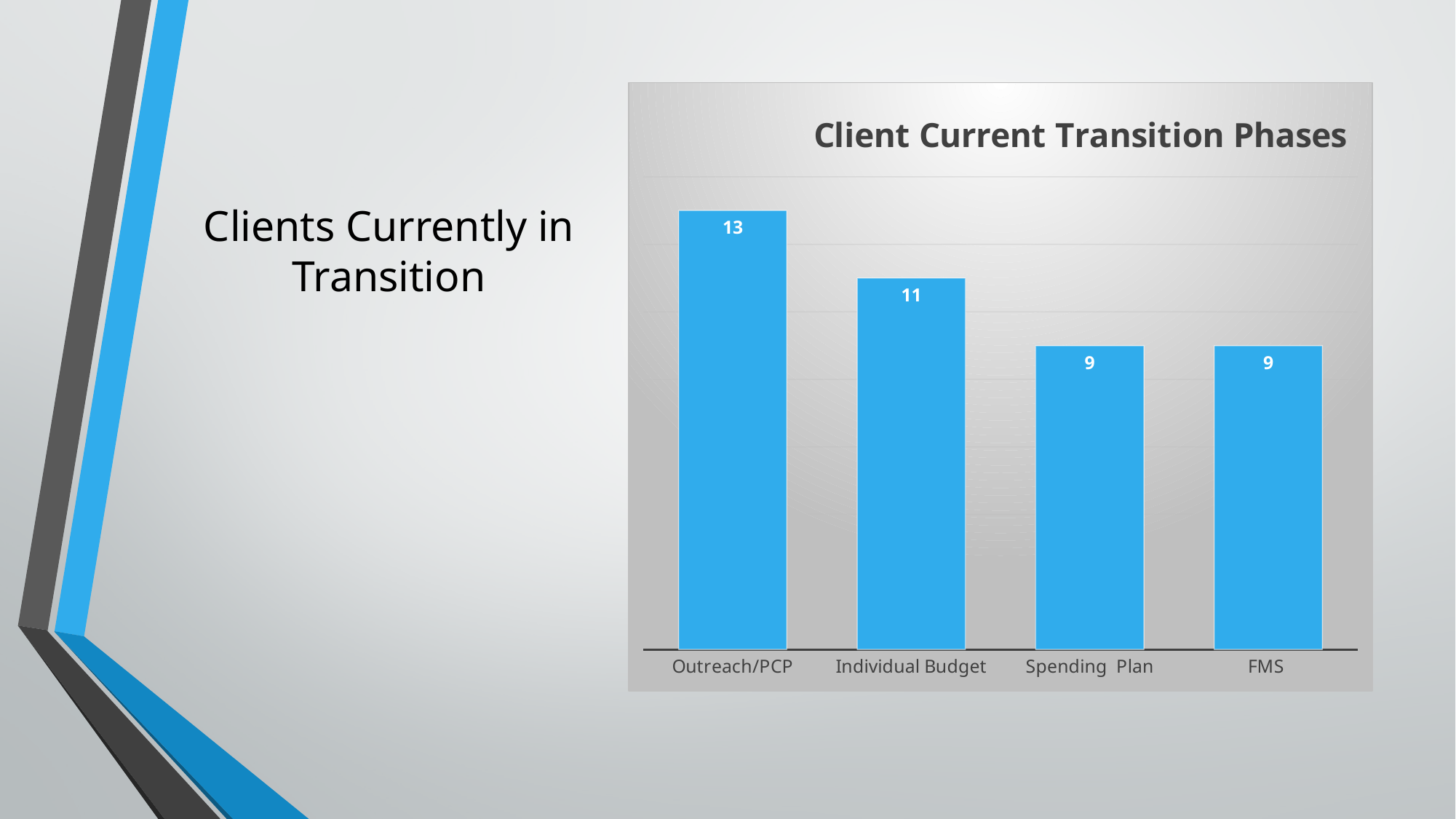
What is the value for Outreach/PCP? 13 What is the difference between the values for Individual Budget and FMS? 2 Do the values rise or fall from left to right along the x axis? Fall Which category has the highest value? Outreach/PCP What kind of chart is shown? Bar chart How many categories are shown on the x axis? 4 What is the difference between the values for Outreach/PCP and Individual Budget? 2 What is the value for FMS? 9 Which is larger, the value for Outreach/PCP or the value for Spending Plan? Outreach/PCP What is the value for Spending Plan? 9 What is the value for Individual Budget? 11 What is the title of the chart? Client Current Transition Phases